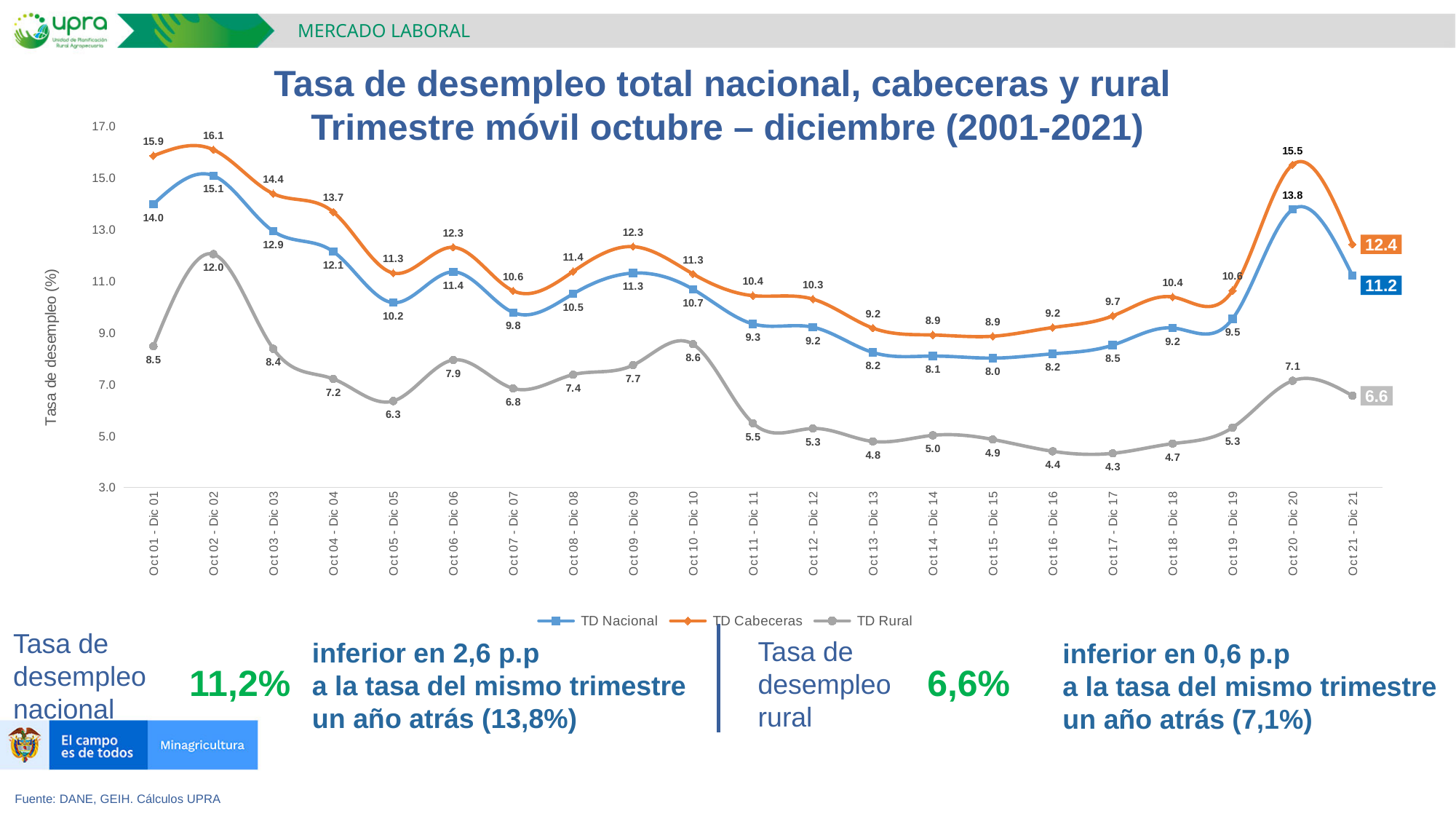
What is the value of TD Rural for Oct 17 - Dic 17? 4.3 In which period does TD Rural reach its lowest value? Oct 17 - Dic 17 Does TD Nacional rise or fall from Oct 09 - Dic 09 to Oct 15 - Dic 15? Fall What kind of chart is shown on the slide? Line chart Which period has the higher TD Rural value, Oct 02 - Dic 02 or Oct 20 - Dic 20? Oct 02 - Dic 02 By how much did TD Nacional fall from Oct 20 - Dic 20 to Oct 21 - Dic 21? 2.6 In which period does TD Cabeceras reach its highest value? Oct 02 - Dic 02 How many periods are plotted on the x axis? 21 How many series does the legend list? 3 What is the value of TD Cabeceras for Oct 02 - Dic 02? 16.1 What is the difference between TD Cabeceras and TD Nacional in Oct 21 - Dic 21? 1.2 What is the value of TD Nacional for Oct 21 - Dic 21? 11.2